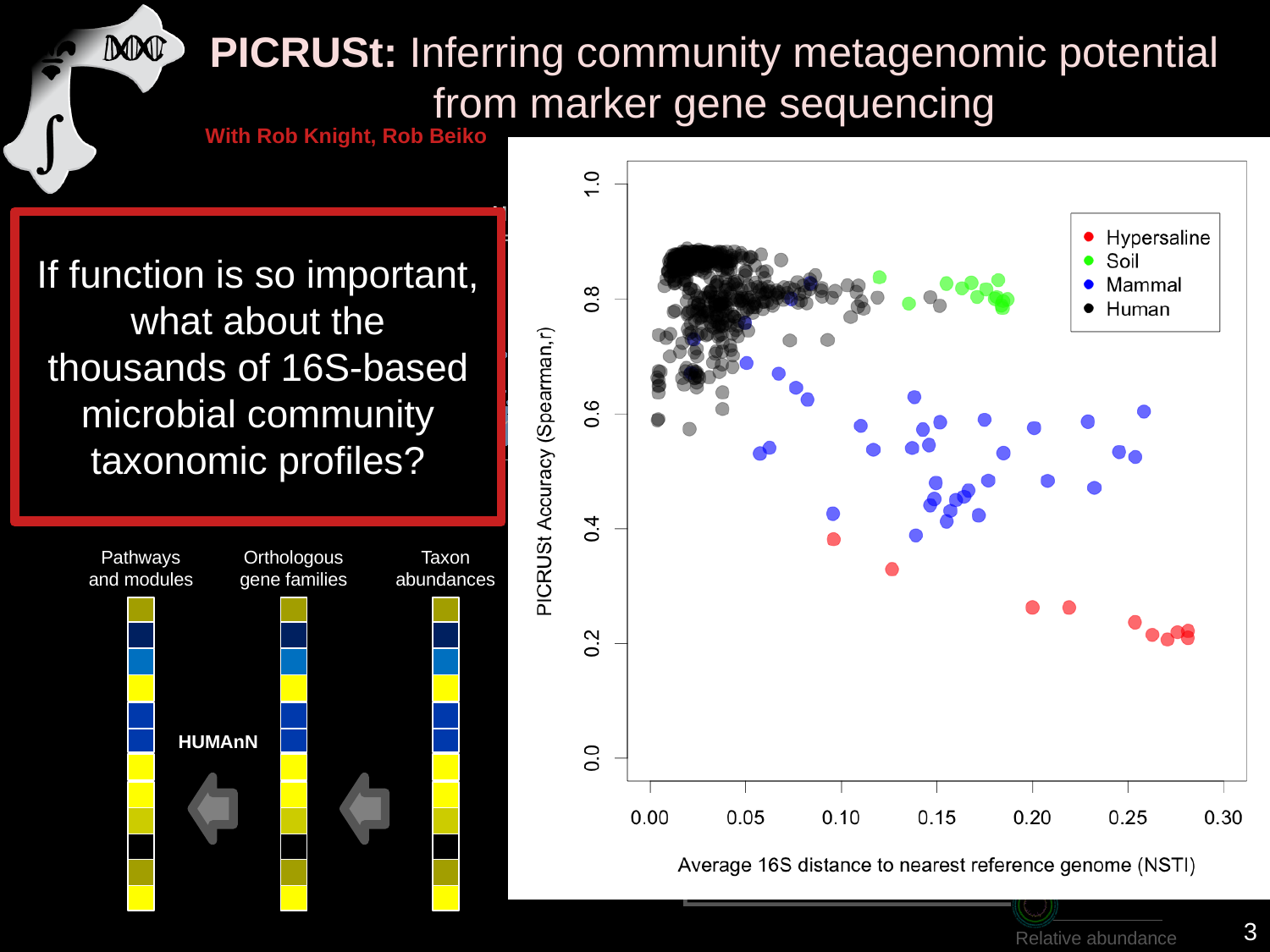
Which series in the scatter plot has the lowest PICRUSt accuracy values? Hypersaline Which series in the scatter plot is clustered at the smallest NSTI values, near 0.00 to 0.05? Human Are the Soil points in the scatter plot greater or less than 0.6 in PICRUSt accuracy? greater Is the PICRUSt accuracy of the Mammal points generally greater or less than that of the Human points? less What colour represents the Soil series in the scatter plot? green What kind of chart is shown on the slide? scatter plot What is the label of the y axis of the scatter plot? PICRUSt Accuracy (Spearman,r) Are the Hypersaline points at the far right of the scatter plot (NSTI around 0.25 to 0.28) greater or less than 0.4 in PICRUSt accuracy? less Is the PICRUSt accuracy of the Soil points greater or less than that of the Hypersaline points? greater Which series in the scatter plot reaches the largest values of average 16S distance (NSTI)? Hypersaline As the average 16S distance to nearest reference genome (NSTI) increases along the x axis, does PICRUSt accuracy generally rise or fall? fall How many series does the legend of the scatter plot list? 4